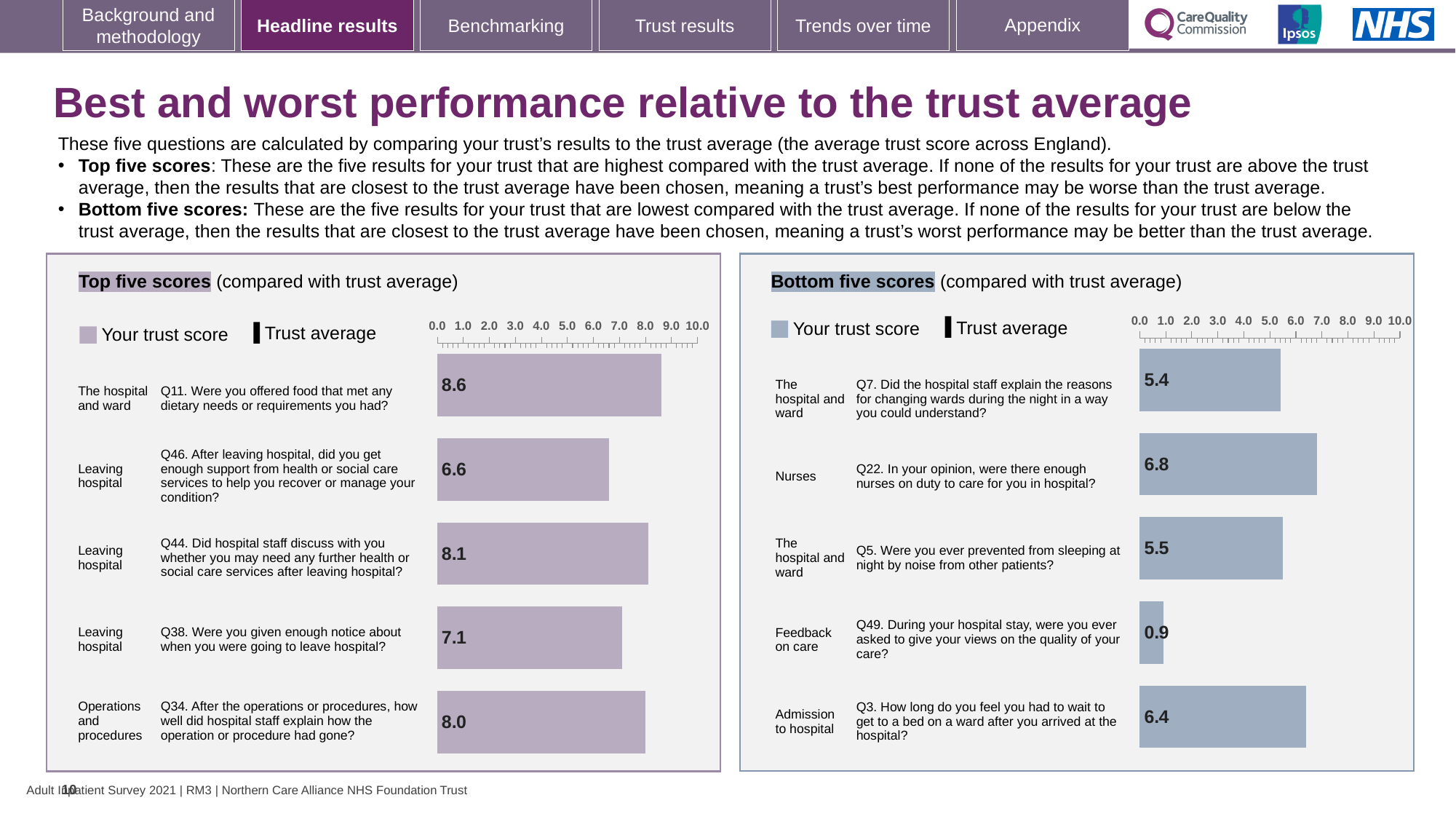
In the 'Top five scores' chart, which question has the lowest trust score? Q46 How many questions are plotted in the 'Top five scores' chart? 5 In the 'Top five scores' chart, what is the trust score for Q34 (After the operations or procedures, how well did hospital staff explain how the operation or procedure had gone?)? 8.0 In the 'Bottom five scores' chart, what is the trust score for Q49 (During your hospital stay, were you ever asked to give your views on the quality of your care?)? 0.9 In the 'Bottom five scores' chart, which question has the highest trust score? Q22 In the 'Top five scores' chart, which question has the highest trust score? Q11 In the 'Top five scores' chart, what is the difference between the trust scores for Q11 and Q46? 2.0 In the 'Top five scores' chart, what is the trust score for Q11 (Were you offered food that met any dietary needs or requirements you had?)? 8.6 What kind of chart is the 'Bottom five scores' chart? Bar chart In the 'Bottom five scores' chart, which question has the lowest trust score? Q49 In the 'Bottom five scores' chart, which has the larger trust score, Q7 or Q5? Q5 In the 'Bottom five scores' chart, what is the difference between the trust scores for Q22 and Q3? 0.4